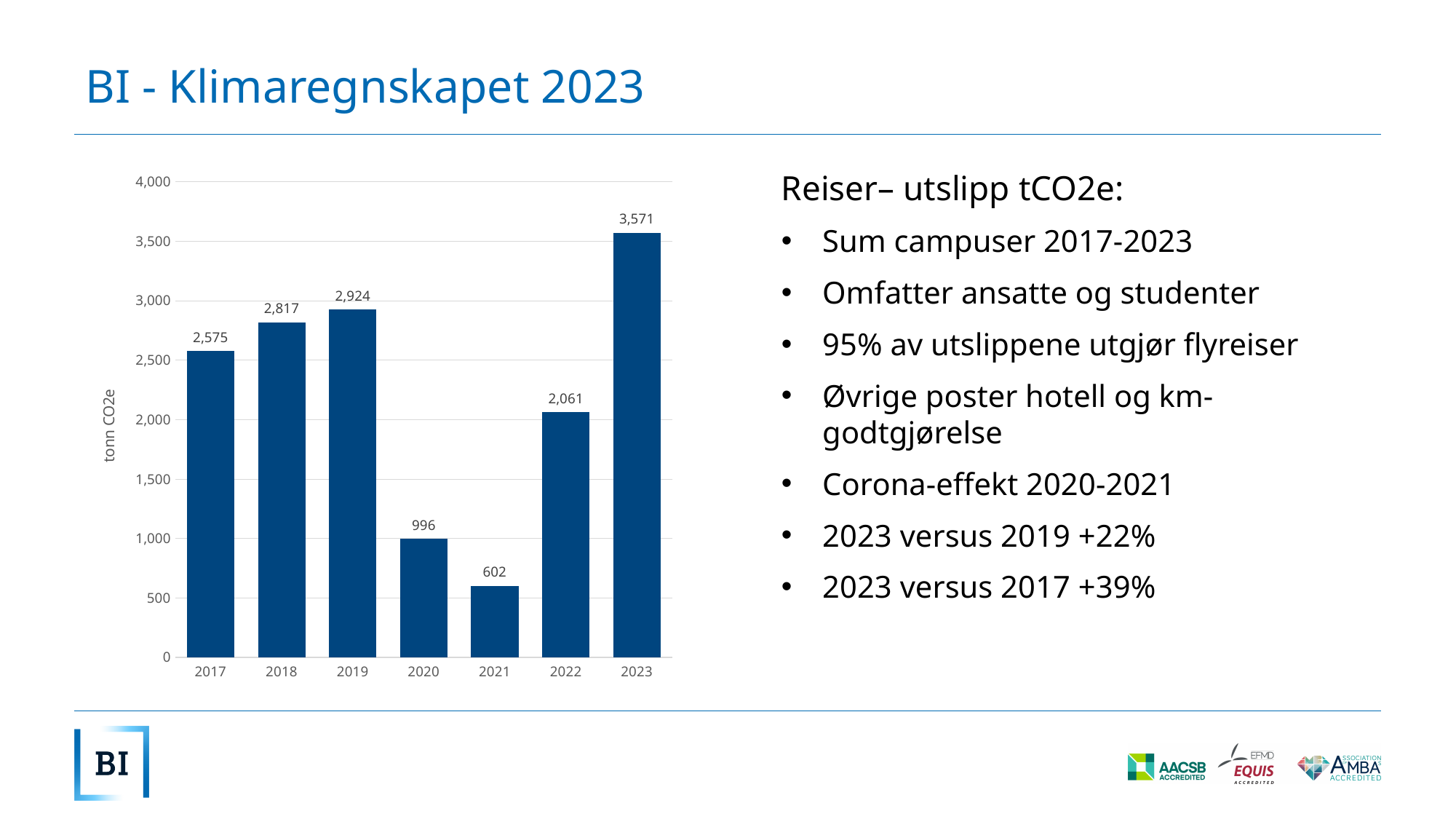
Which year has the highest value? 2023 Which year has the lowest value? 2021 How many years are shown on the x axis? 7 What kind of chart is shown on the slide? Bar chart What is the difference between the values for 2020 and 2021? 394 What is the value for 2017? 2,575 What is the value for 2021? 602 Is the value for 2022 greater or less than 2,000? greater What is the label on the y axis of the chart? tonn CO2e Which is larger, the value for 2018 or the value for 2022? 2018 What is the value for 2023? 3,571 What is the difference between the values for 2023 and 2019? 647